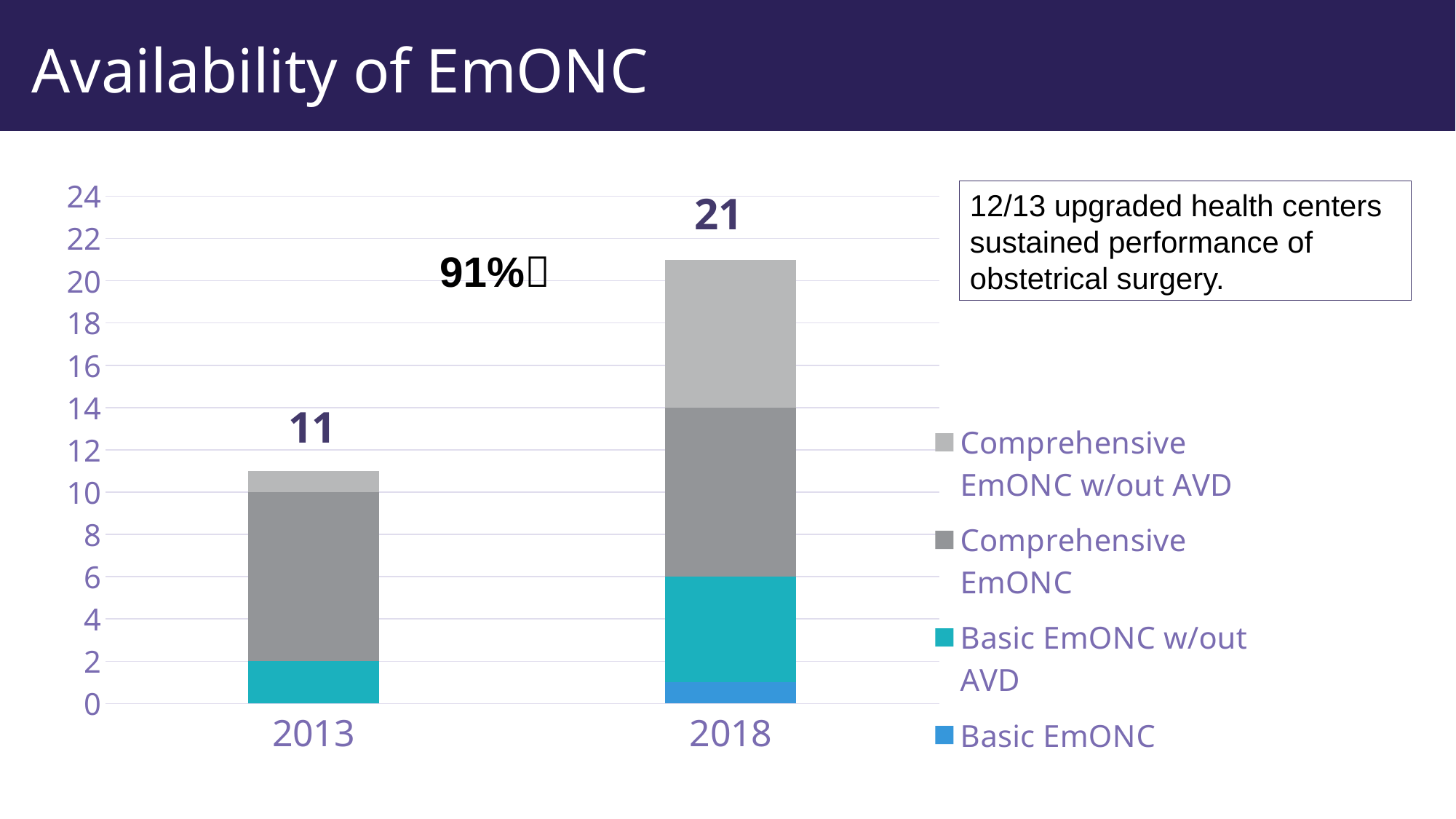
How many years (categories) are shown on the x axis? 2 What is the difference between the 2018 total and the 2013 total? 10 What is the total value of the stacked bar for 2013? 11 What kind of chart is shown on the slide? Stacked bar chart How many series does the legend list? 4 Do the totals rise or fall from 2013 to 2018? Rise Which year has the higher total, 2013 or 2018? 2018 What is the total value of the stacked bar for 2018? 21 What is the value of the Basic EmONC w/out AVD segment in 2013? 2 Is the value of the Comprehensive EmONC w/out AVD segment in 2018 greater or less than 4? greater What percentage increase is annotated on the chart between the two bars? 91%